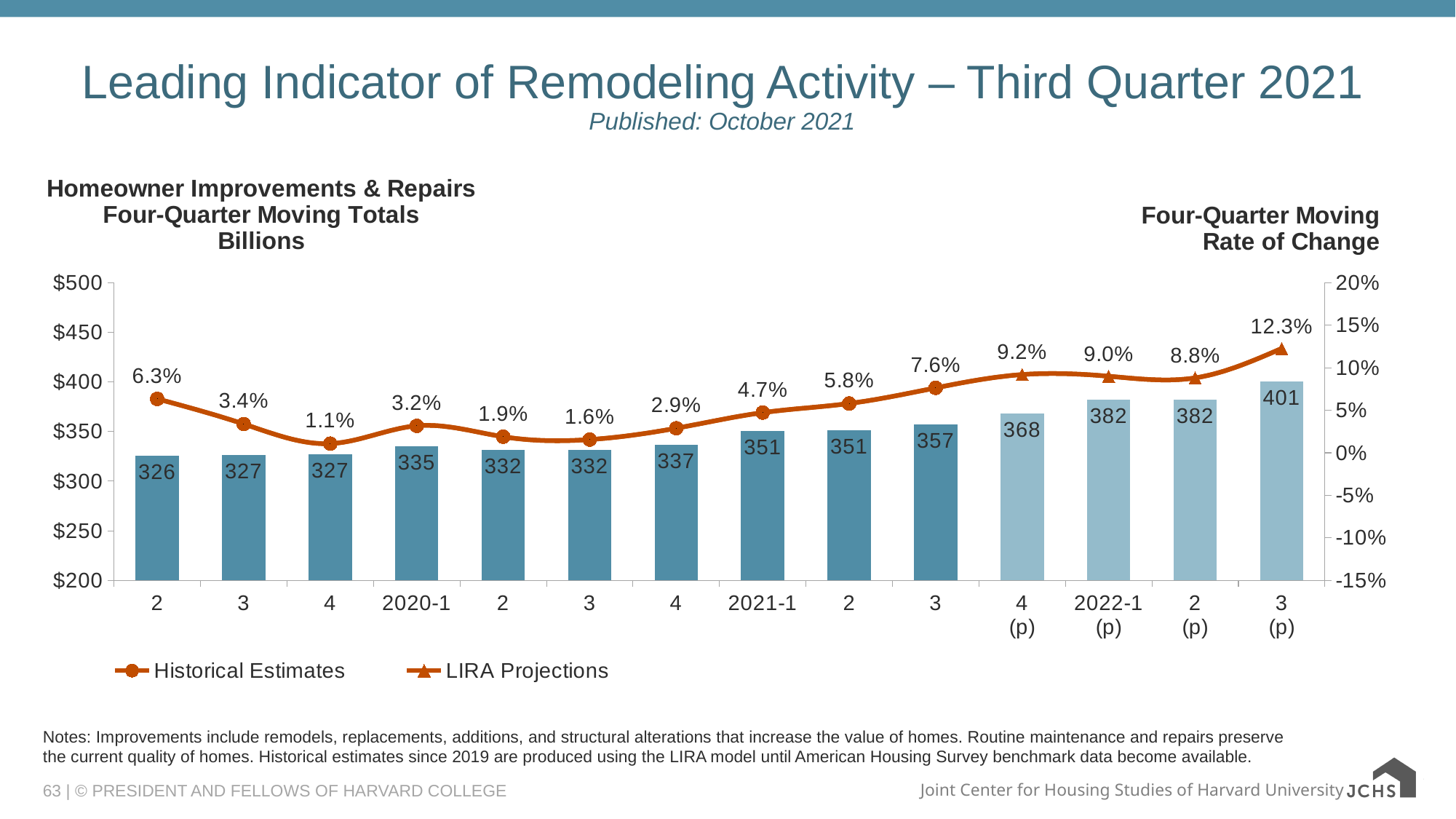
How many series does the legend list? 2 What is the difference between the four-quarter moving totals for 2022-3 (p) and 2022-2 (p)? 19 Is the rate of change for 2021-4 (p) greater or less than 5%? greater Which quarter has the highest four-quarter moving rate of change? 2022 quarter 3 (p), 12.3% Which quarter has the lowest four-quarter moving rate of change? 2019 quarter 4, 1.1% Which is larger, the rate of change for 2021-3 or for 2021-2? 2021-3 (7.6%) How many quarters are shown on the x axis? 14 What is the four-quarter moving rate of change for 2020-1? 3.2% What is the projected four-quarter moving total for 2022-1 (p)? 382 What is the four-quarter moving total (in billions) for 2021-1? 351 Do the four-quarter moving totals generally rise or fall from 2019 quarter 2 to 2022 quarter 3 (p)? Rise What kind of chart is this? Combination bar and line chart